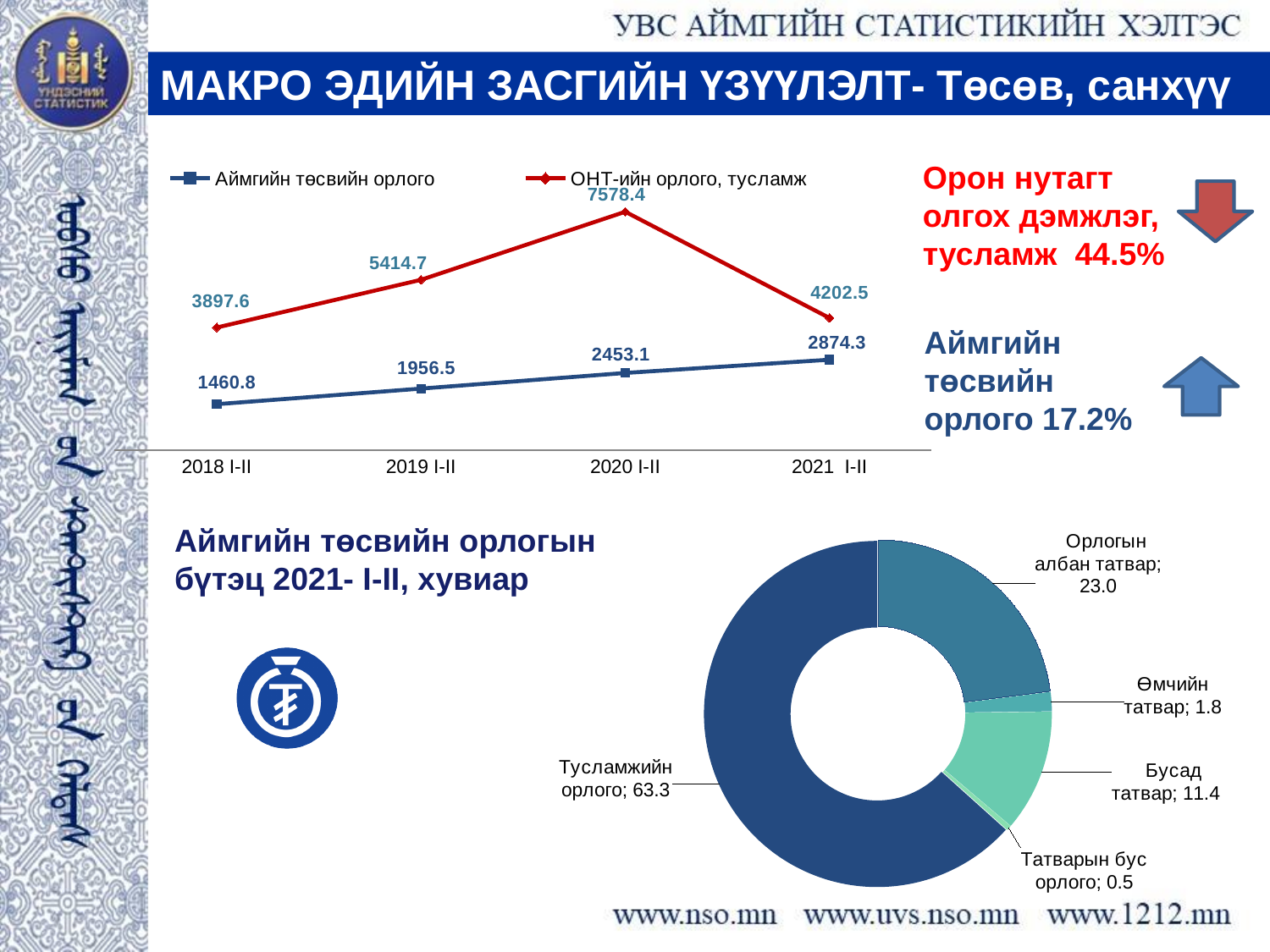
In the top line chart, does Аймгийн төсвийн орлого rise or fall from 2018 I-II to 2021 I-II? rise In the top line chart, in which period is Аймгийн төсвийн орлого lowest? 2018 I-II In the doughnut chart 'Аймгийн төсвийн орлогын бүтэц 2021- I-II, хувиар', which is larger: Бусад татвар or Өмчийн татвар? Бусад татвар How many periods are shown on the x axis of the top line chart? 4 How many series does the legend of the top line chart list? 2 In the top line chart, in which period is ОНТ-ийн орлого, тусламж highest? 2020 I-II In the doughnut chart 'Аймгийн төсвийн орлогын бүтэц 2021- I-II, хувиар', what is the value for Орлогын албан татвар? 23.0 In the doughnut chart 'Аймгийн төсвийн орлогын бүтэц 2021- I-II, хувиар', which category has the largest share? Тусламжийн орлого In the top line chart, what is the difference between ОНТ-ийн орлого, тусламж and Аймгийн төсвийн орлого in 2018 I-II? 2436.8 What kind of chart is the chart titled 'Аймгийн төсвийн орлогын бүтэц 2021- I-II, хувиар'? doughnut chart In the top line chart, what is the value of Аймгийн төсвийн орлого for 2021 I-II? 2874.3 In the top line chart, what is the value of ОНТ-ийн орлого, тусламж for 2020 I-II? 7578.4